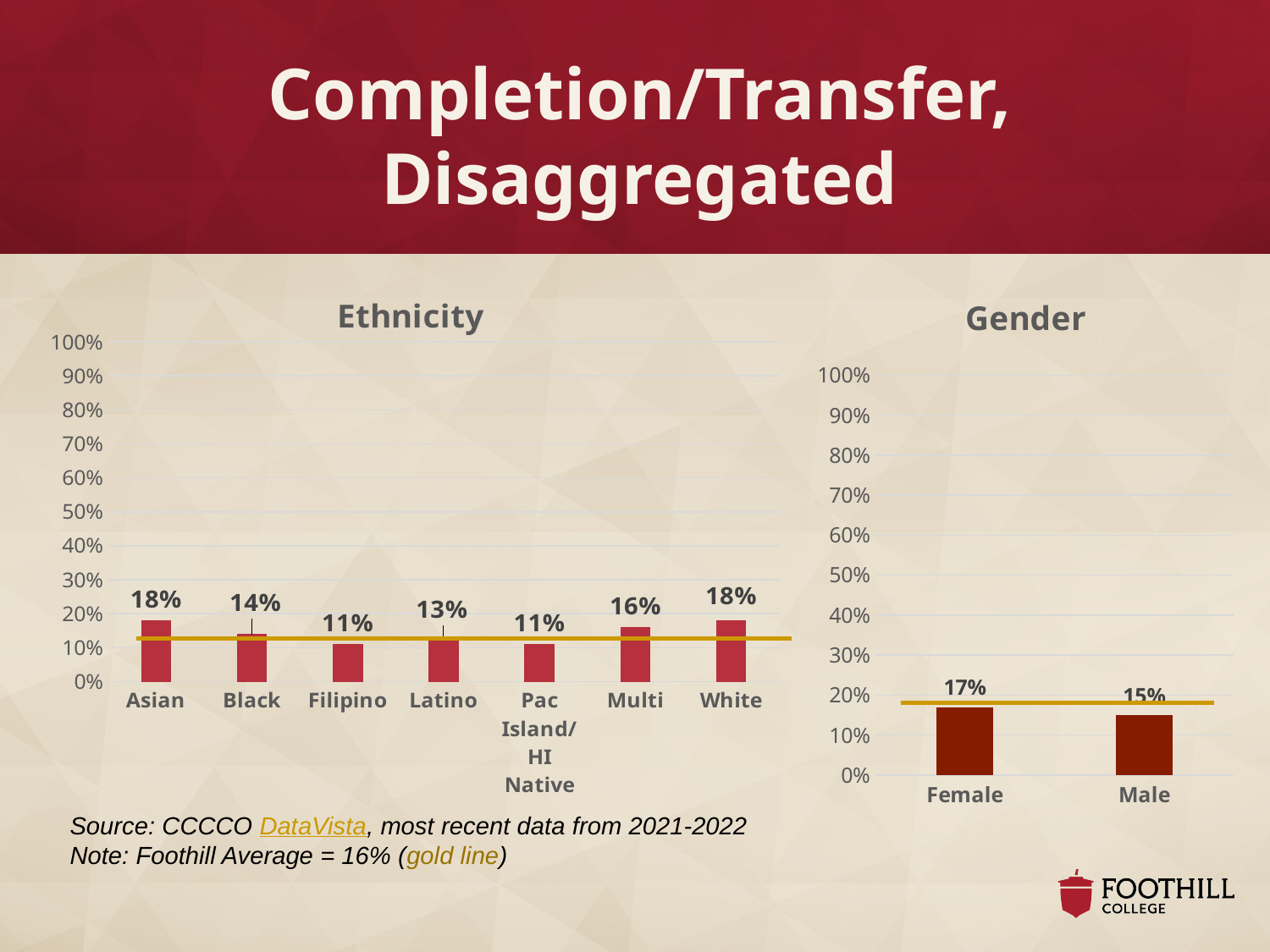
In the Gender chart, which category has the lower value? Male In the Ethnicity chart, what is the value for Latino? 13% How many categories are shown in the Ethnicity chart? 7 In the Gender chart, what is the difference between the values for Female and Male? 2% In the Gender chart, which category has the higher value? Female According to the note on the slide, what does the gold line on the charts represent? Foothill Average = 16% In the Ethnicity chart, what is the value for Black? 14% In the Gender chart, what is the value for Female? 17% In the Ethnicity chart, which is larger, the value for Multi or the value for Latino? Multi What kind of chart is the Gender chart? Bar chart In the Ethnicity chart, what is the difference between the values for Asian and Filipino? 7% In the Ethnicity chart, what is the value for Multi? 16%